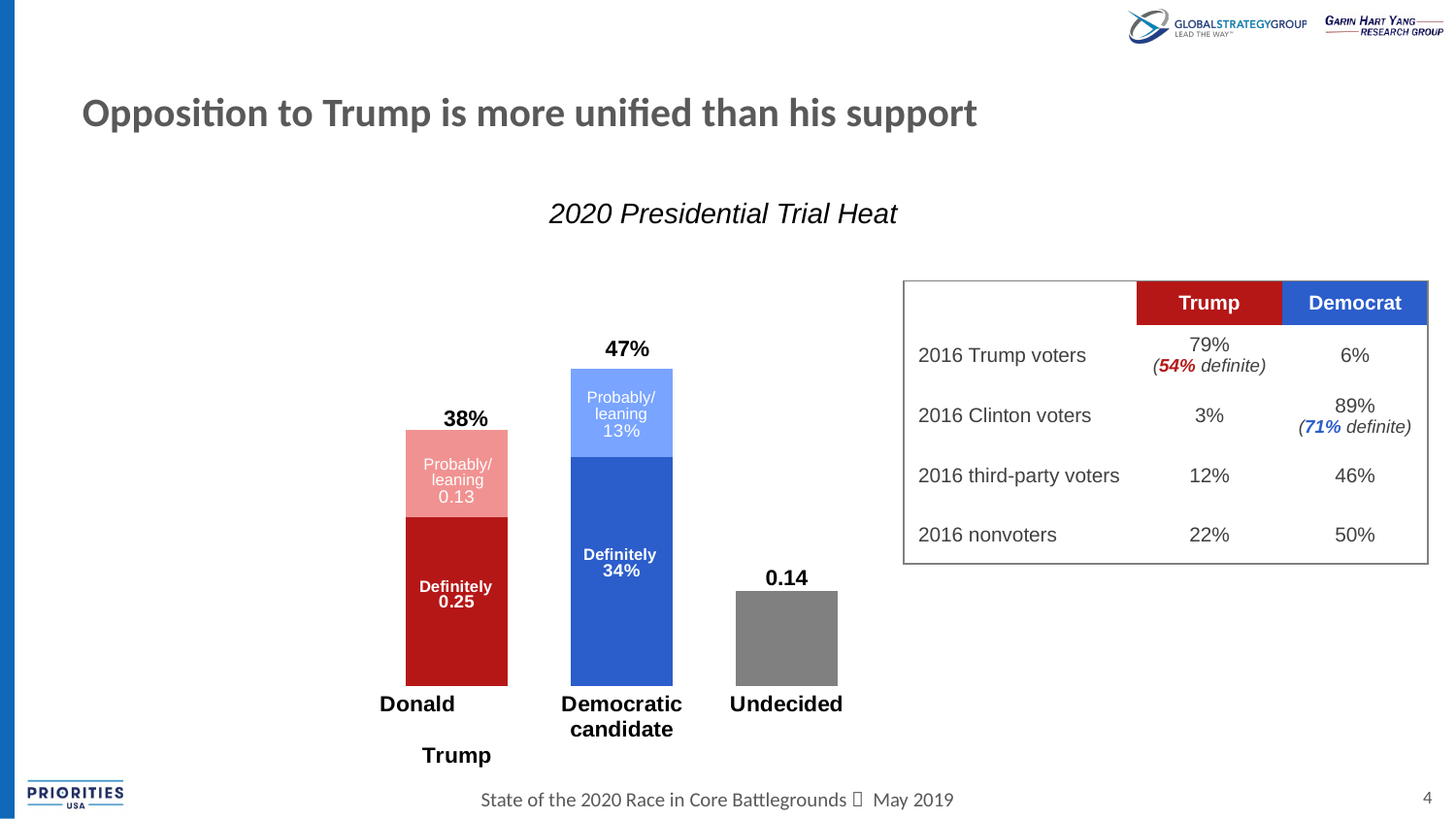
Which is larger, the Democratic candidate's total or Donald Trump's total? Democratic candidate What is the total value shown above the Democratic candidate bar? 47% What value is shown for the Undecided bar? 0.14 Which category has the highest total in the chart? Democratic candidate What is the difference between the Democratic candidate's total and Donald Trump's total? 9% What is the 'Probably/leaning' value for the Democratic candidate? 13% What type of chart is shown on the slide? Stacked bar chart What is the 'Definitely' value for the Democratic candidate? 34% What is the 'Definitely' value for Donald Trump? 0.25 What is the total value shown above the Donald Trump bar? 38% How many categories are shown on the x axis of the chart? 3 Which category has the lowest value in the chart? Undecided